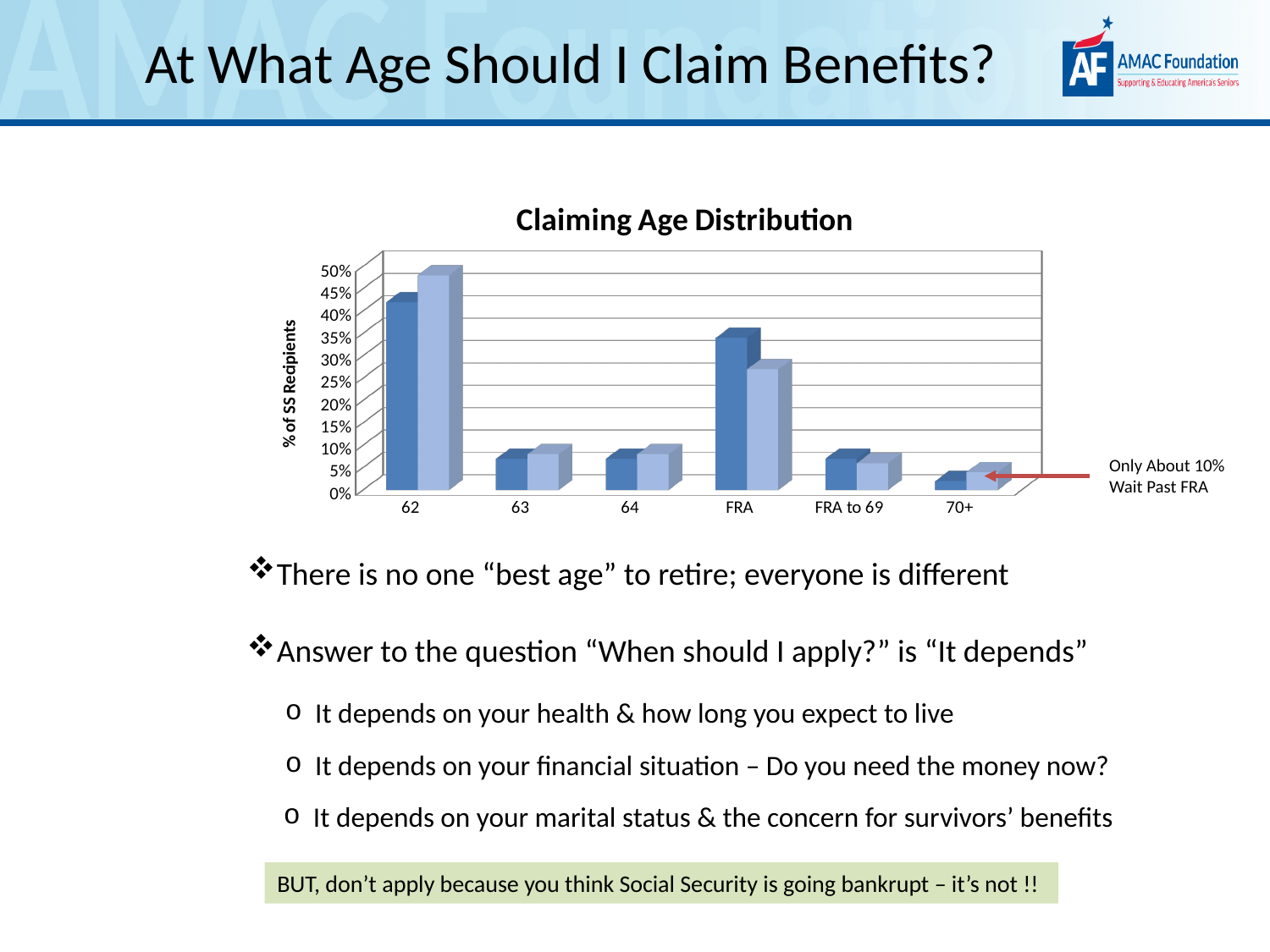
Is the lighter blue bar for FRA greater or less than 30%? less Is the darker blue bar for 63 greater or less than 10%? less Which category has taller bars, FRA or 63? FRA Which claiming-age category has the highest bars in the chart? 62 Is the darker blue bar for FRA greater or less than 30%? greater What is the title of the chart on the slide? Claiming Age Distribution Which category has taller bars, 62 or FRA? 62 Which claiming-age category has the lowest bars in the chart? 70+ What is the label on the vertical axis of the chart? % of SS Recipients What type of chart is shown on the slide? bar chart How many claiming-age categories are shown on the x axis of the chart? 6